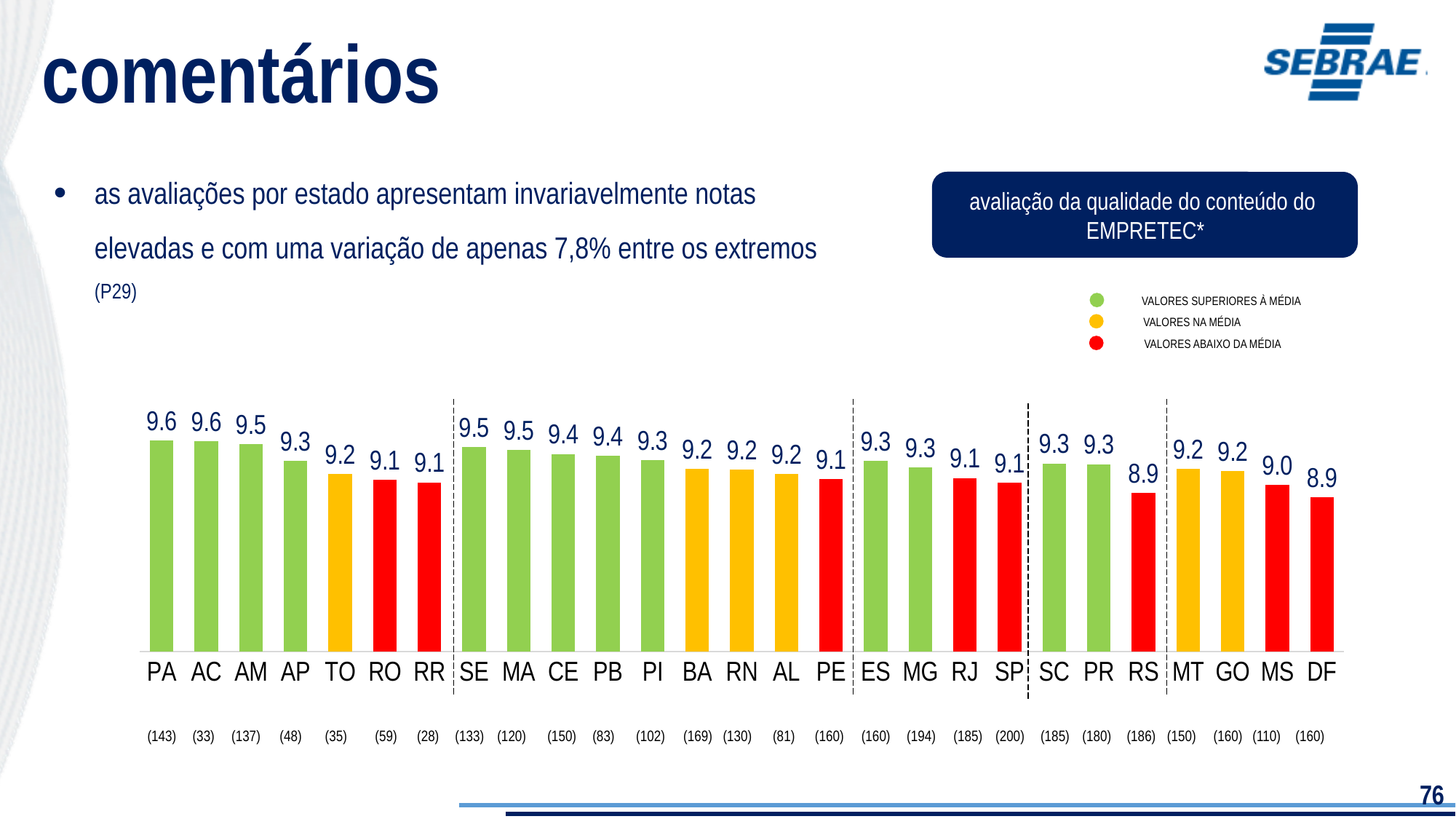
What is the title of the chart? avaliação da qualidade do conteúdo do EMPRETEC* How many entries does the legend list? 3 How many states (categories) are shown on the chart? 27 What is the value for MS? 9.0 What kind of chart is shown on the slide? bar chart What is the value for RS? 8.9 What is the highest value shown on the chart? 9.6 What is the value for PI? 9.3 What is the value for CE? 9.4 What is the difference between the values for PA and DF? 0.7 Which is larger, the value for AM or the value for RS? AM What is the lowest value shown on the chart? 8.9